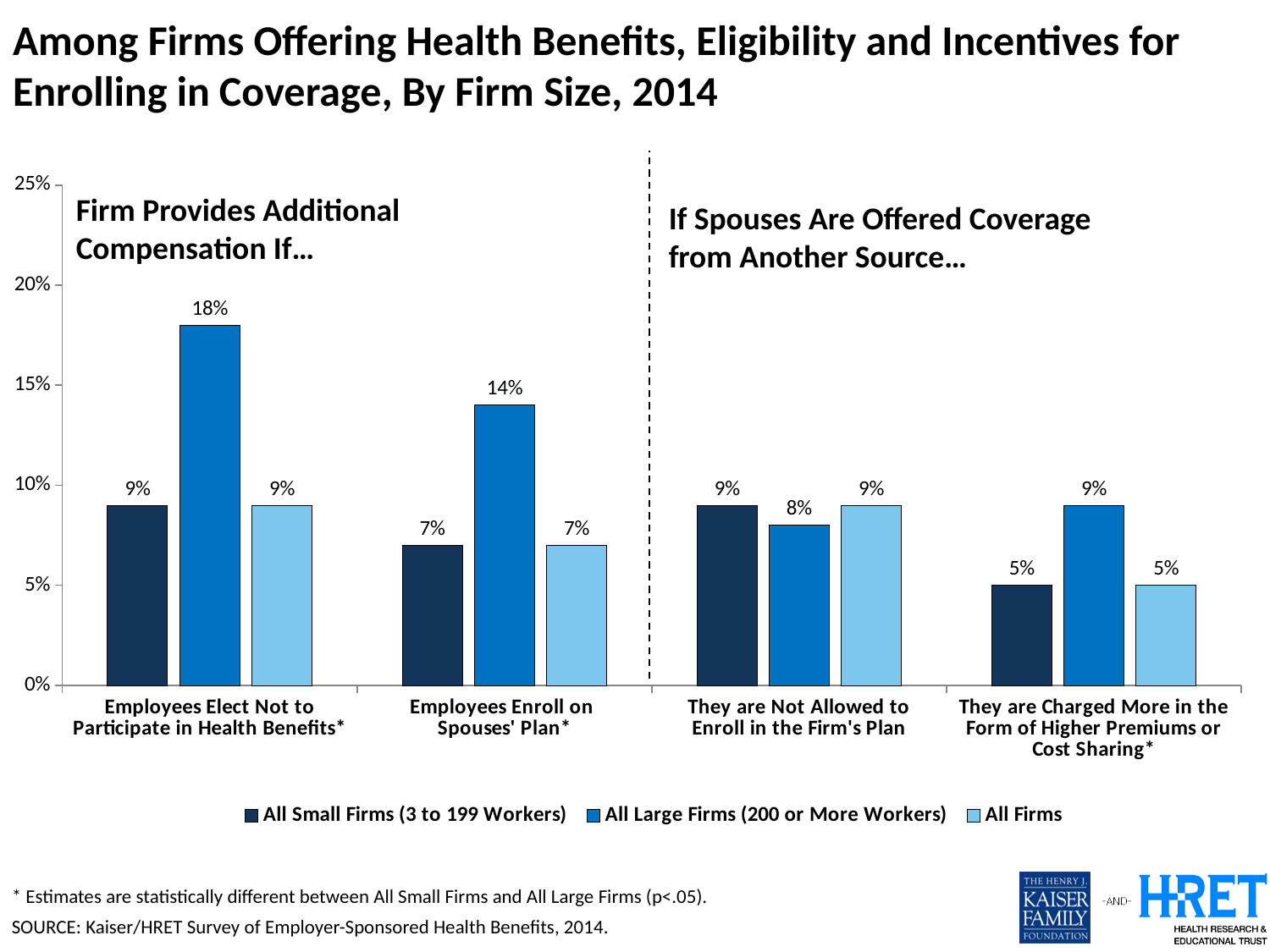
Which category has the lowest value for All Small Firms (3 to 199 Workers)? They are Charged More in the Form of Higher Premiums or Cost Sharing* How many series does the legend list? 3 What is the difference between All Large Firms and All Firms in the 'Employees Enroll on Spouses' Plan*' category? 7% Which category has the highest value for All Large Firms (200 or More Workers)? Employees Elect Not to Participate in Health Benefits* What kind of chart is shown on the slide? Bar chart What is the difference between All Large Firms and All Small Firms in the 'Employees Elect Not to Participate in Health Benefits*' category? 9% How many categories are shown on the x axis? 4 In the 'They are Not Allowed to Enroll in the Firm's Plan' category, which is larger: All Small Firms or All Large Firms? All Small Firms What is the value for All Small Firms (3 to 199 Workers) in the 'Employees Enroll on Spouses' Plan*' category? 7% What is the value for All Large Firms (200 or More Workers) in the 'They are Charged More in the Form of Higher Premiums or Cost Sharing*' category? 9% What is the value for All Large Firms (200 or More Workers) in the 'Employees Elect Not to Participate in Health Benefits*' category? 18% What is the value for All Firms in the 'They are Not Allowed to Enroll in the Firm's Plan' category? 9%